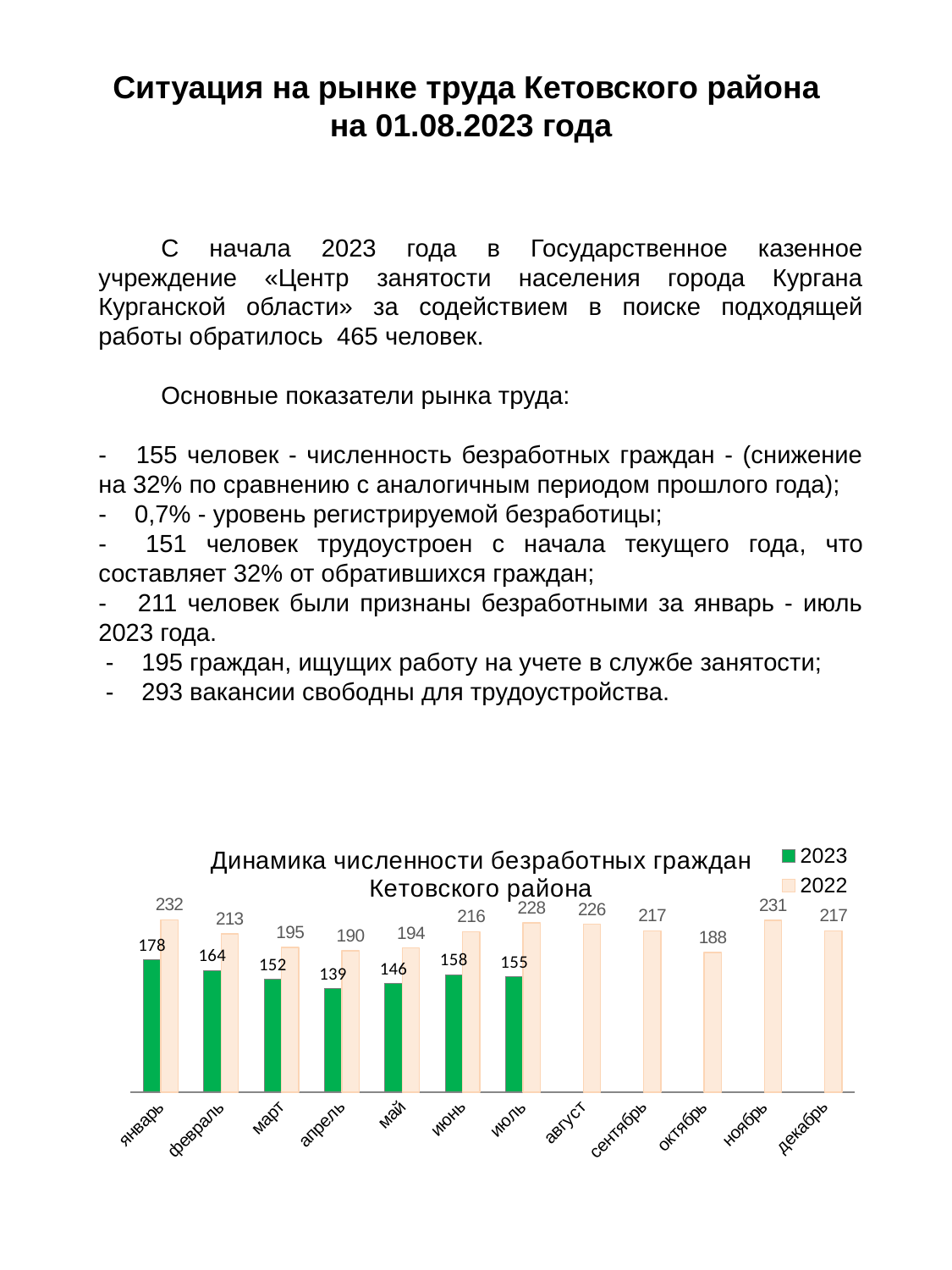
How many series does the legend list? 2 What is the title of the chart? Динамика численности безработных граждан Кетовского района What is the value for 2022 in ноябрь? 231 Which month has the lowest value for the 2022 series? октябрь What kind of chart is shown on the slide? bar chart What is the value for 2023 in апрель? 139 What is the difference between the 2022 and 2023 values in январь? 54 Which is larger: the 2022 value in июль or the 2022 value in август? июль What is the value for 2022 in октябрь? 188 Do the 2023 values rise or fall from январь to апрель? fall How many months have a value plotted for the 2023 series? 7 Which month has the highest value for the 2023 series? январь